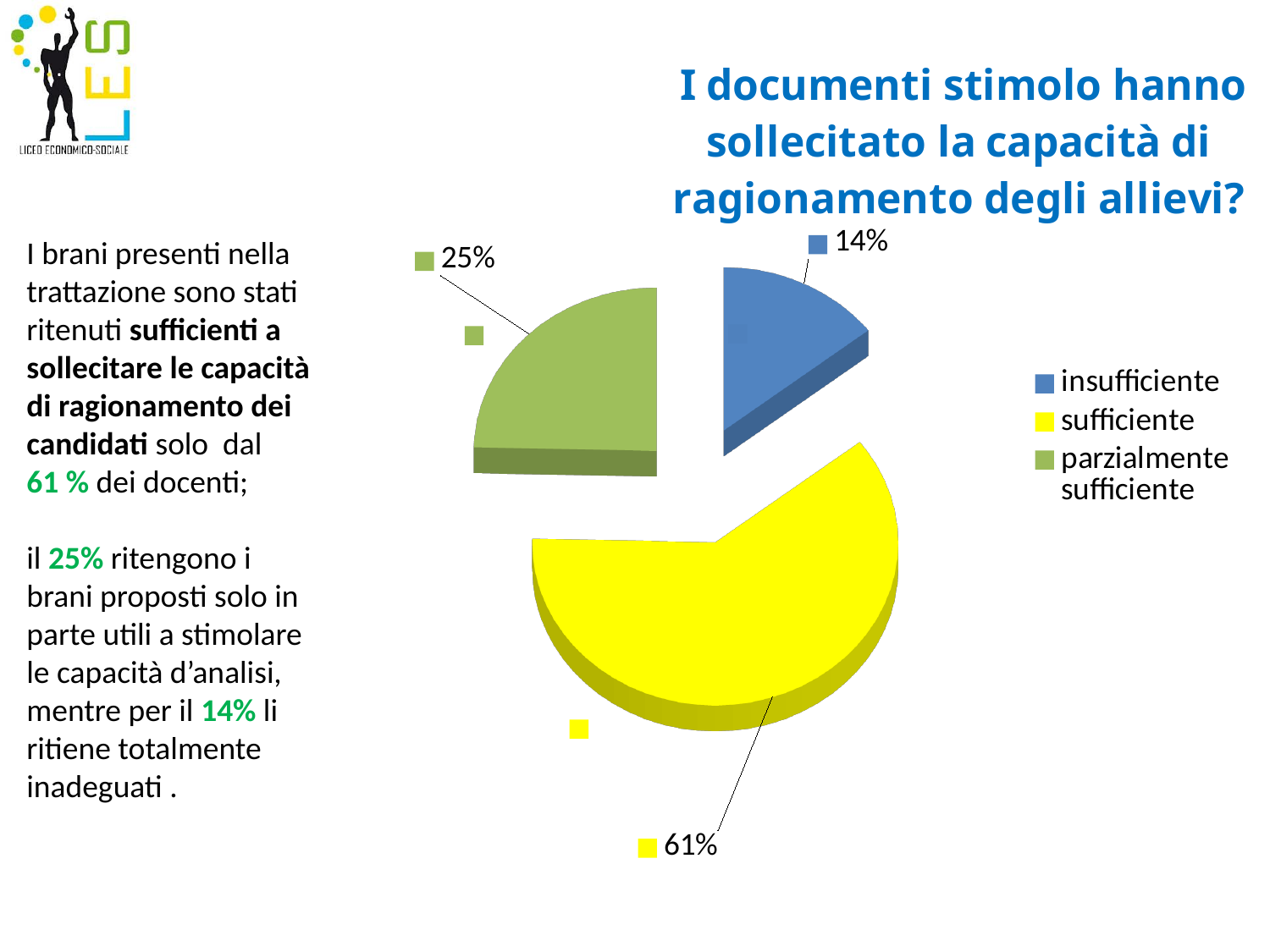
What is the difference in percentage points between the 'sufficiente' and 'parzialmente sufficiente' slices? 36 What percentage of the pie is labelled 'parzialmente sufficiente'? 25% Which slice is larger, 'parzialmente sufficiente' or 'insufficiente'? parzialmente sufficiente Which category has the smallest slice of the pie? insufficiente Which category has the largest slice of the pie? sufficiente What is the difference in percentage points between the 'parzialmente sufficiente' and 'insufficiente' slices? 11 What colour is the 'sufficiente' slice? yellow What is the title of the chart? I documenti stimolo hanno sollecitato la capacità di ragionamento degli allievi? What kind of chart is shown on the slide? pie chart How many categories does the legend list? 3 What percentage of the pie is labelled 'sufficiente'? 61% What percentage of the pie is labelled 'insufficiente'? 14%